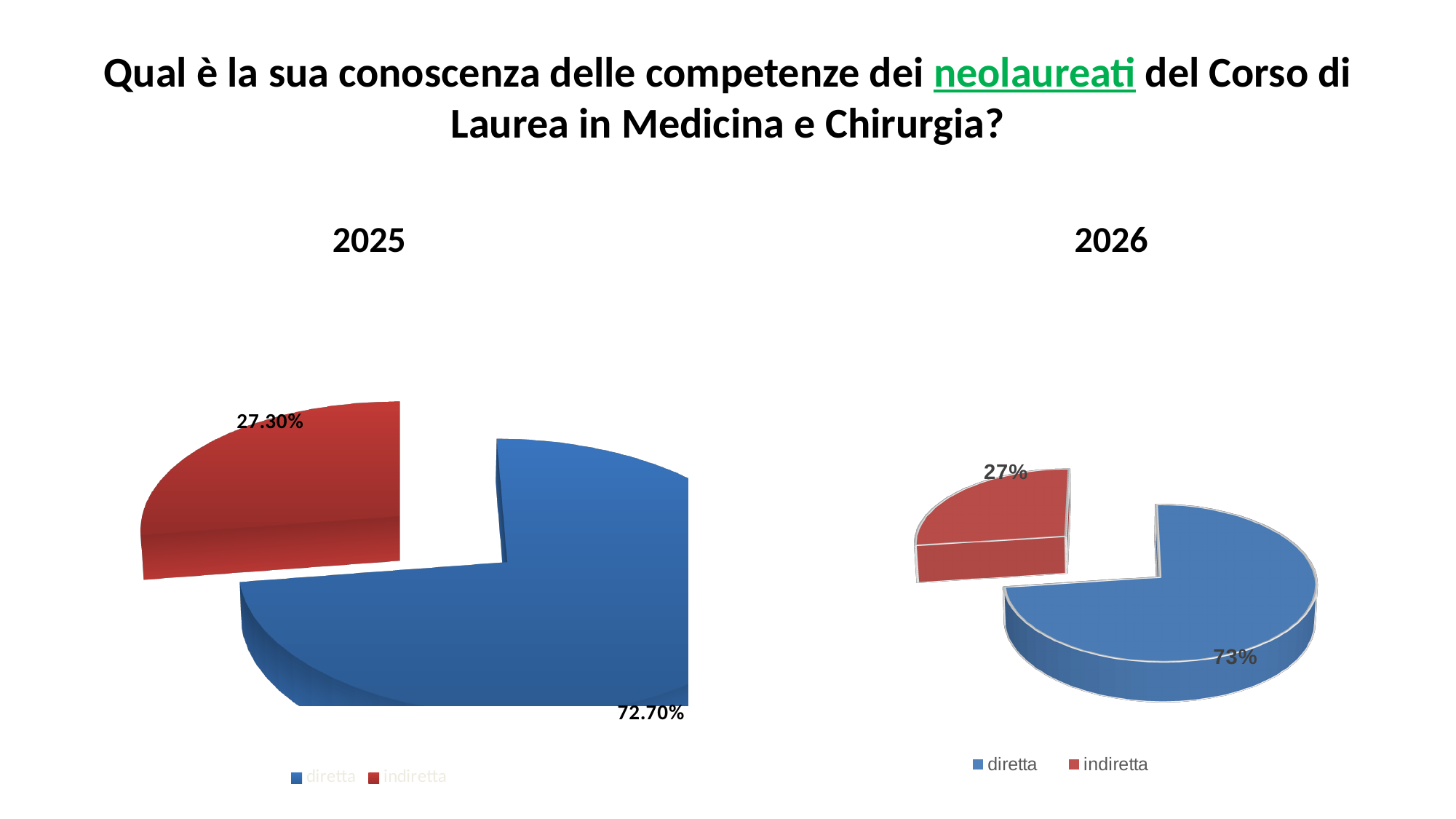
In the 2025 chart, what is the value for indiretta? 27.30% How many categories does the 2026 chart show? 2 In the 2025 chart, what is the value for diretta? 72.70% In the 2026 chart, what is the value for indiretta? 27% Which colour represents indiretta in the 2025 chart? red In the 2026 chart, which category has the smallest slice? indiretta In the 2025 chart, which category has the largest slice? diretta In the 2026 chart, what is the difference between the diretta and indiretta values? 46% In the 2025 chart, what is the difference between the diretta and indiretta values? 45.40% In the 2026 chart, which is larger, diretta or indiretta? diretta In the 2026 chart, what is the value for diretta? 73% What kind of chart is the 2025 chart? pie chart